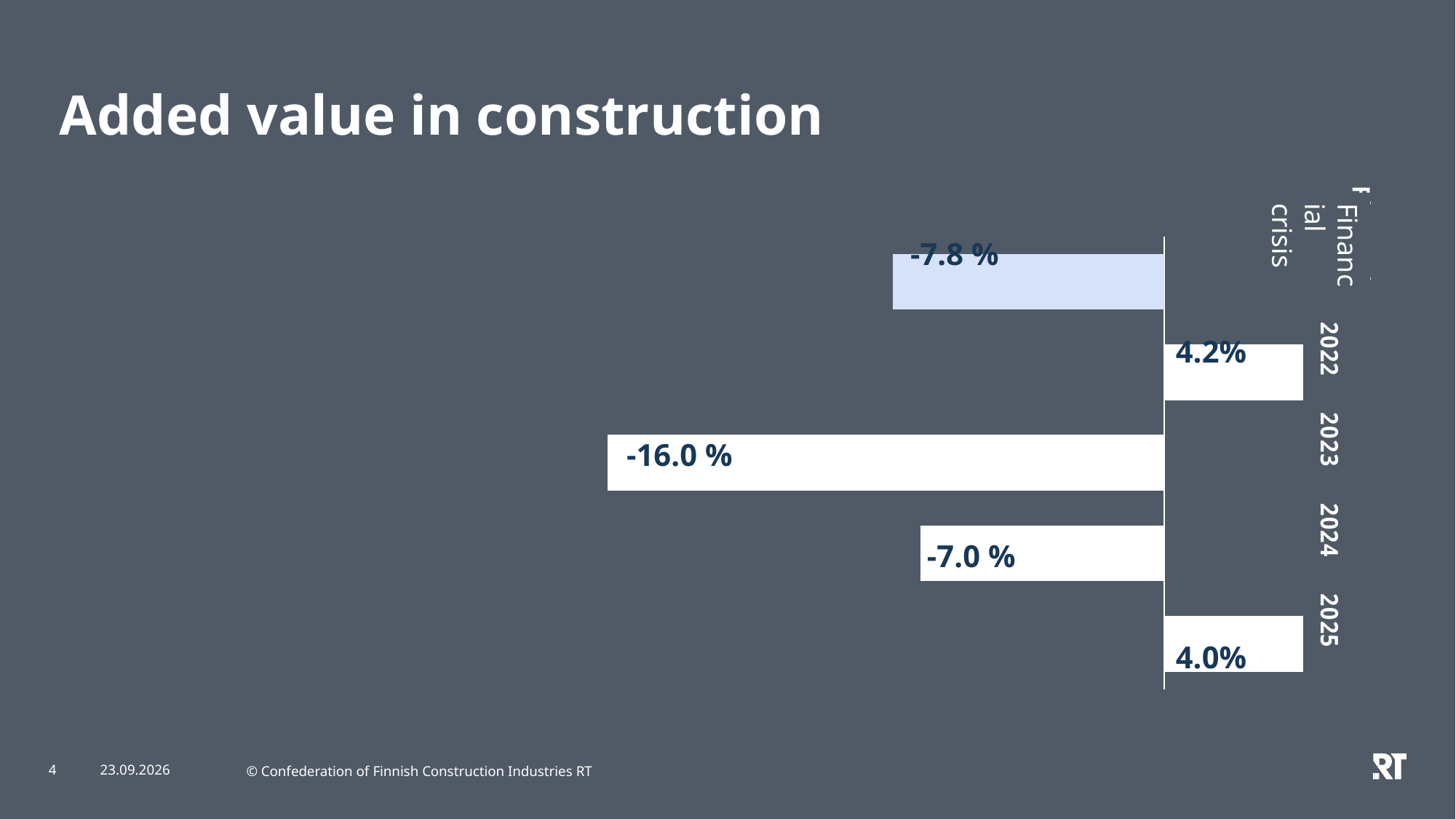
What is the title of the slide? Added value in construction Which is larger, the value for 2022 or the value for 2025? 2022 How many categories are plotted in the chart? 5 What is the value shown for 2024? -7.0 % What is the value shown for the Financial crisis bar? -7.8 % What is the value shown for 2022? 4.2% What kind of chart is shown on the slide? Bar chart What is the value shown for 2023? -16.0 % Which category has the lowest value? 2023 What is the value shown for 2025? 4.0% Which category has the highest value? 2022 What is the difference in percentage points between the values for 2023 and 2024? 9.0 percentage points